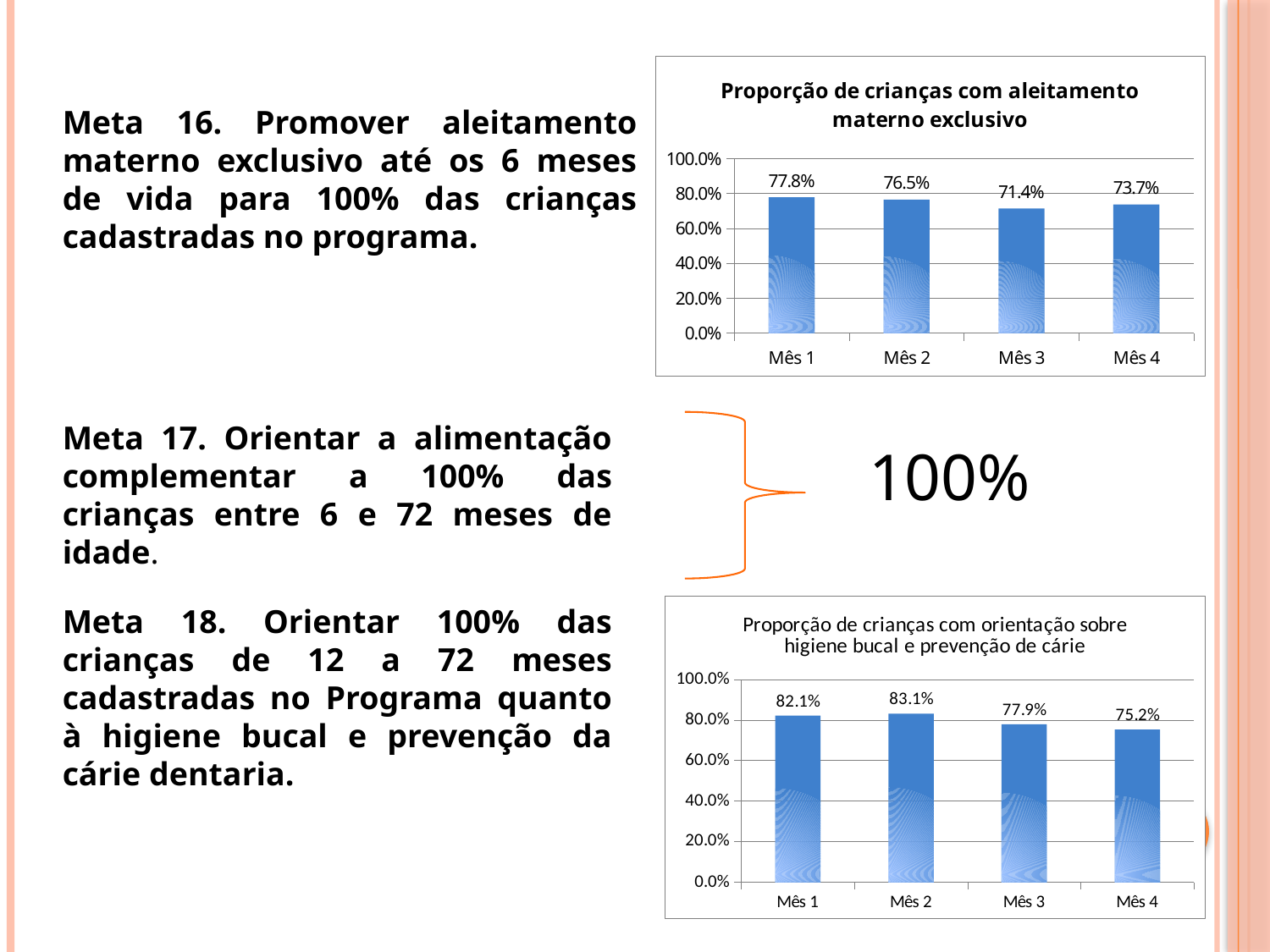
In the chart 'Proporção de crianças com orientação sobre higiene bucal e prevenção de cárie', which month has the lowest value? Mês 4 In the chart 'Proporção de crianças com aleitamento materno exclusivo', what is the value for Mês 1? 77.8% In the chart 'Proporção de crianças com orientação sobre higiene bucal e prevenção de cárie', what is the value for Mês 2? 83.1% In the chart 'Proporção de crianças com aleitamento materno exclusivo', how many months are shown on the x axis? 4 In the chart 'Proporção de crianças com aleitamento materno exclusivo', is the value for Mês 2 larger than the value for Mês 4? Yes In the chart 'Proporção de crianças com orientação sobre higiene bucal e prevenção de cárie', is the value for Mês 3 greater or less than 80.0%? less What kind of chart is 'Proporção de crianças com orientação sobre higiene bucal e prevenção de cárie'? Bar chart In the chart 'Proporção de crianças com aleitamento materno exclusivo', which month has the lowest value? Mês 3 In the chart 'Proporção de crianças com aleitamento materno exclusivo', what is the difference between Mês 1 and Mês 3? 6.4% In the chart 'Proporção de crianças com orientação sobre higiene bucal e prevenção de cárie', what is the difference between Mês 2 and Mês 4? 7.9% In the chart 'Proporção de crianças com aleitamento materno exclusivo', which month has the highest value? Mês 1 In the chart 'Proporção de crianças com orientação sobre higiene bucal e prevenção de cárie', what is the value for Mês 4? 75.2%